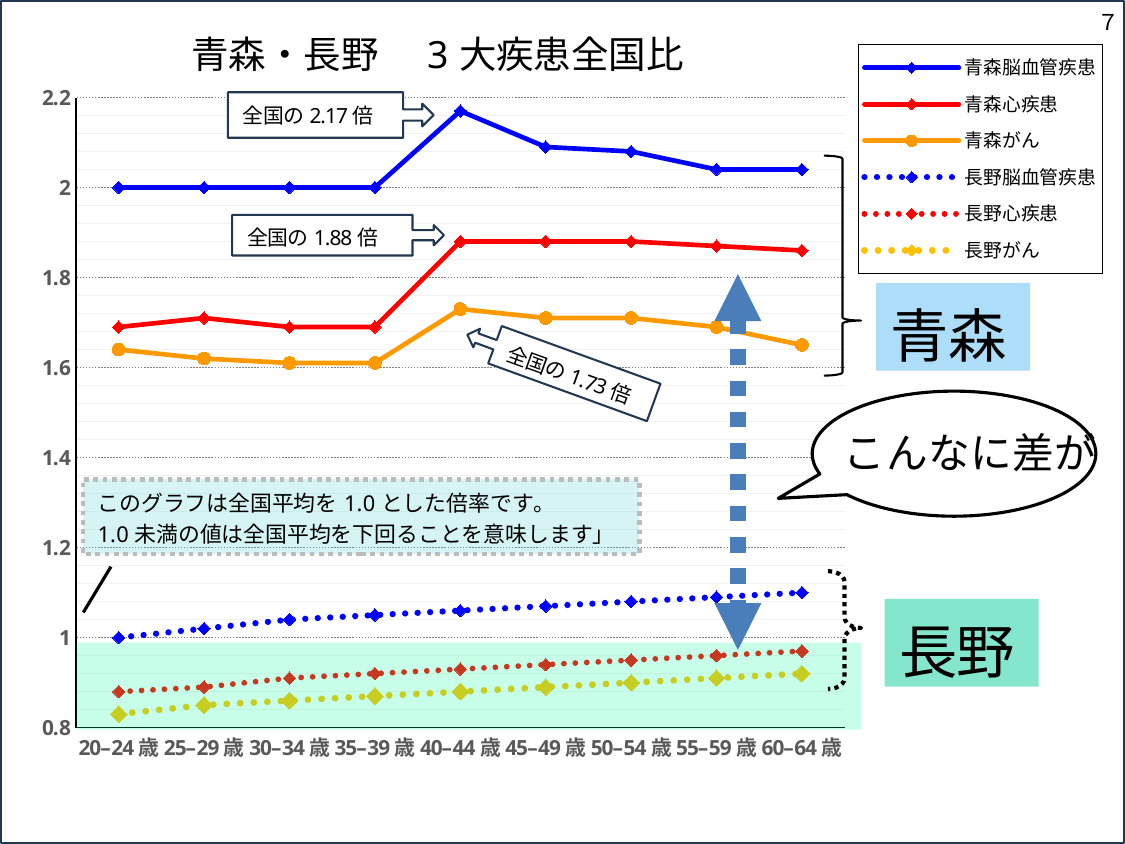
What kind of chart is shown on the slide? Line chart Which series has the highest values on the chart? 青森脳血管疾患 What is the difference between 青森脳血管疾患 and 青森心疾患 in the 40–44歳 age group? 0.29 In the 40–44歳 age group, which is larger: 青森心疾患 or 青森がん? 青森心疾患 How many series does the legend list? 6 What is the value for 青森心疾患 in the 40–44歳 age group? 1.88 What is the value for 青森脳血管疾患 in the 40–44歳 age group? 2.17 Is the value for 長野がん in the 20–24歳 age group greater or less than 1? less How many age groups are shown on the x axis? 9 Is the value for 長野脳血管疾患 in the 60–64歳 age group greater or less than 1? greater What is the value for 青森がん in the 40–44歳 age group? 1.73 In which age group does 青森脳血管疾患 reach its highest value? 40–44歳